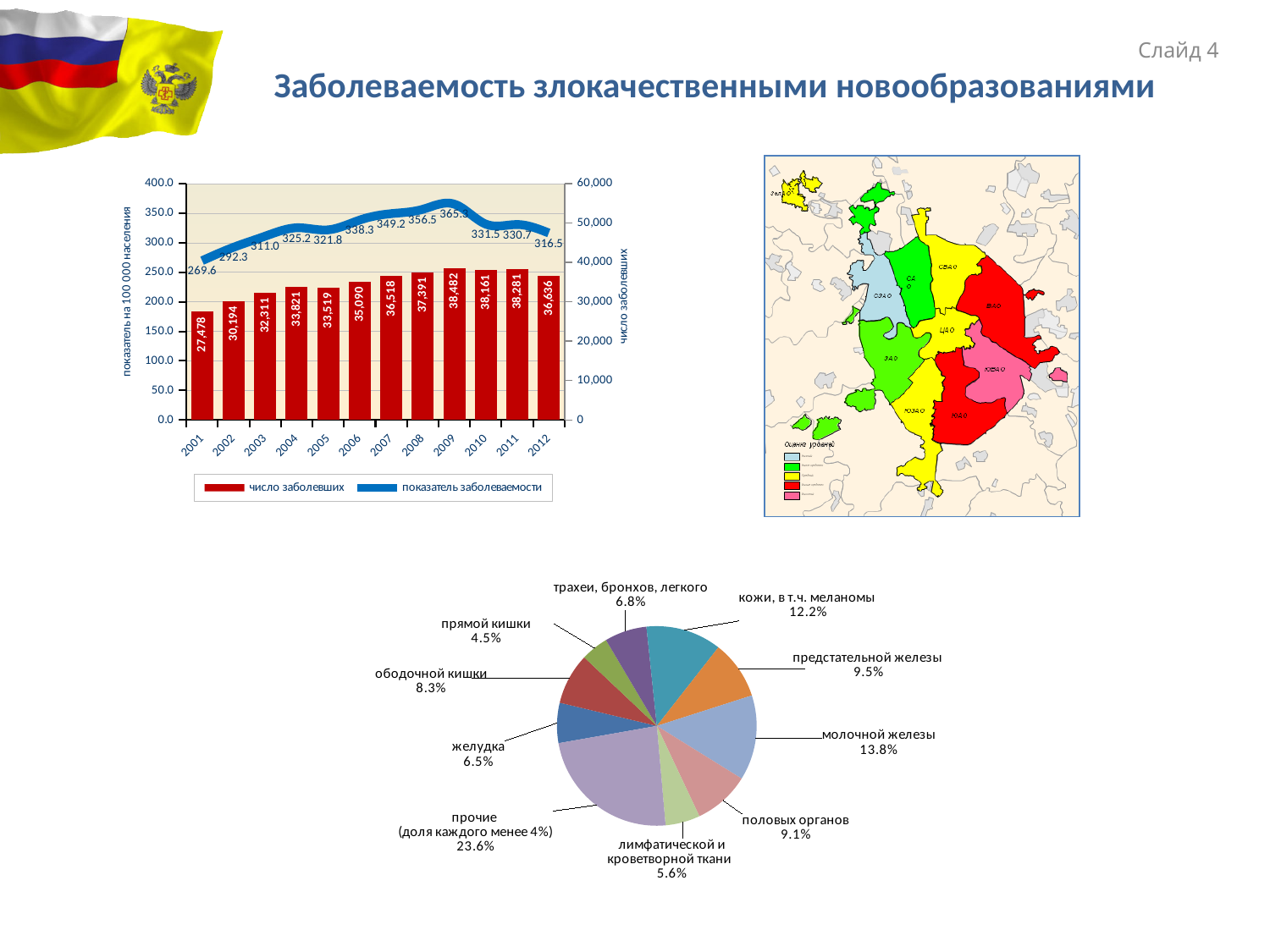
In the top-left chart, is 'число заболевших' larger in 2005 or in 2006? 2006 In the top-left chart, which year has the lowest 'показатель заболеваемости'? 2001 In the top-left chart, what is the value of 'показатель заболеваемости' for 2001? 269.6 In the pie chart at the bottom, what share does 'молочной железы' have? 13.8% In the top-left chart, what is the value of 'число заболевших' for 2009? 38,482 What type of chart is shown at the bottom of the slide? pie chart In the top-left chart, what is the difference in 'число заболевших' between 2012 and 2001? 9,158 In the top-left chart, how many years are shown on the x axis? 12 In the pie chart at the bottom, which category has the smallest share? прямой кишки In the top-left chart, how many series does the legend list? 2 In the top-left chart, which year has the highest 'число заболевших'? 2009 In the top-left chart, does 'число заболевших' rise or fall from 2001 to 2009? rise